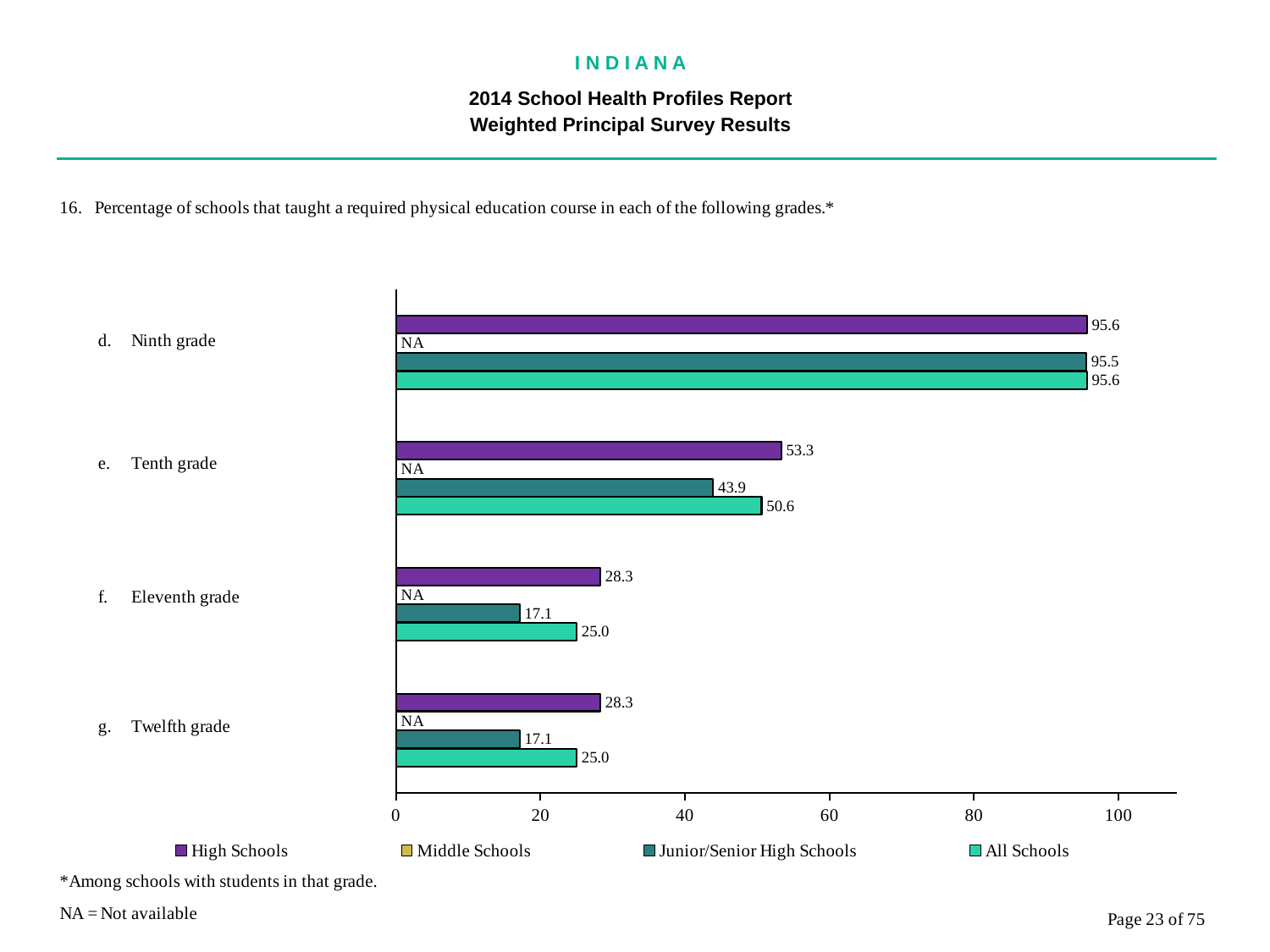
For Eleventh grade, which is larger: the High Schools value or the Junior/Senior High Schools value? High Schools What is the value for Junior/Senior High Schools for Tenth grade? 43.9 What is the value for All Schools for Eleventh grade? 25.0 Which grade has the highest value for All Schools? Ninth grade What is the difference between the High Schools and Junior/Senior High Schools values for Tenth grade? 9.4 Is the All Schools value for Tenth grade greater or less than 40? greater How many grade categories are shown in the chart? 4 What is the value for High Schools for Ninth grade? 95.6 What kind of chart is shown on the slide? Bar chart How many series does the legend list? 4 Which grade has the lowest value for High Schools? Eleventh grade and Twelfth grade (both 28.3) What is shown for Middle Schools for Twelfth grade? NA